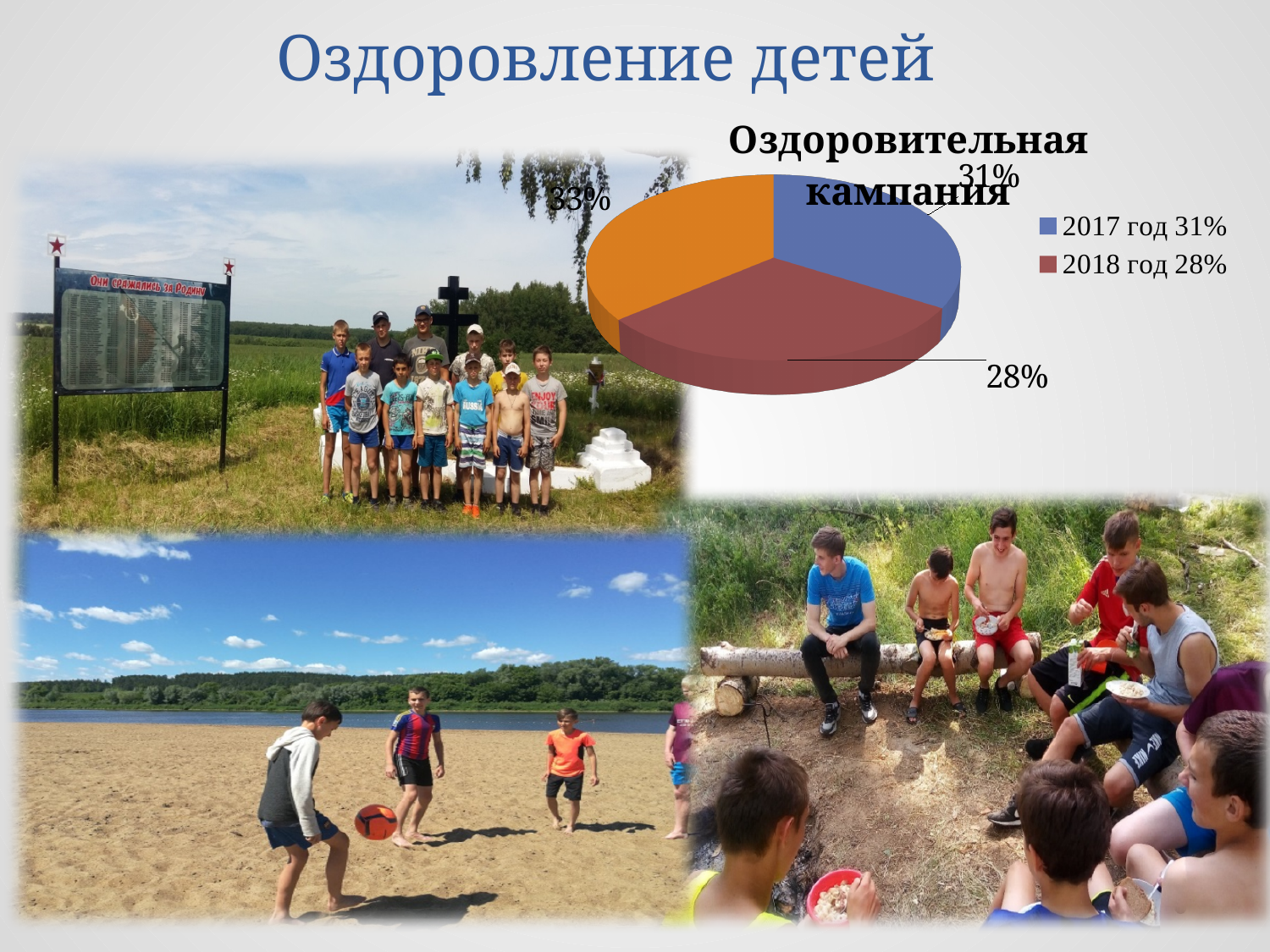
Is the share for 2018 год greater or less than 30%? less What percentage is shown for 2017 год in the pie chart? 31% Which of the labelled years, 2017 год or 2018 год, has the smallest slice in the pie chart? 2018 год What is the difference in percentage points between the 2017 год and 2018 год slices? 3 What kind of chart is shown on the slide? pie chart What is the title of the chart? Оздоровительная кампания Which has the larger share in the pie chart, 2017 год or 2018 год? 2017 год What colour is the slice for 2017 год in the pie chart? blue How many slices does the pie chart have? 3 What percentage is shown for 2018 год in the pie chart? 28%